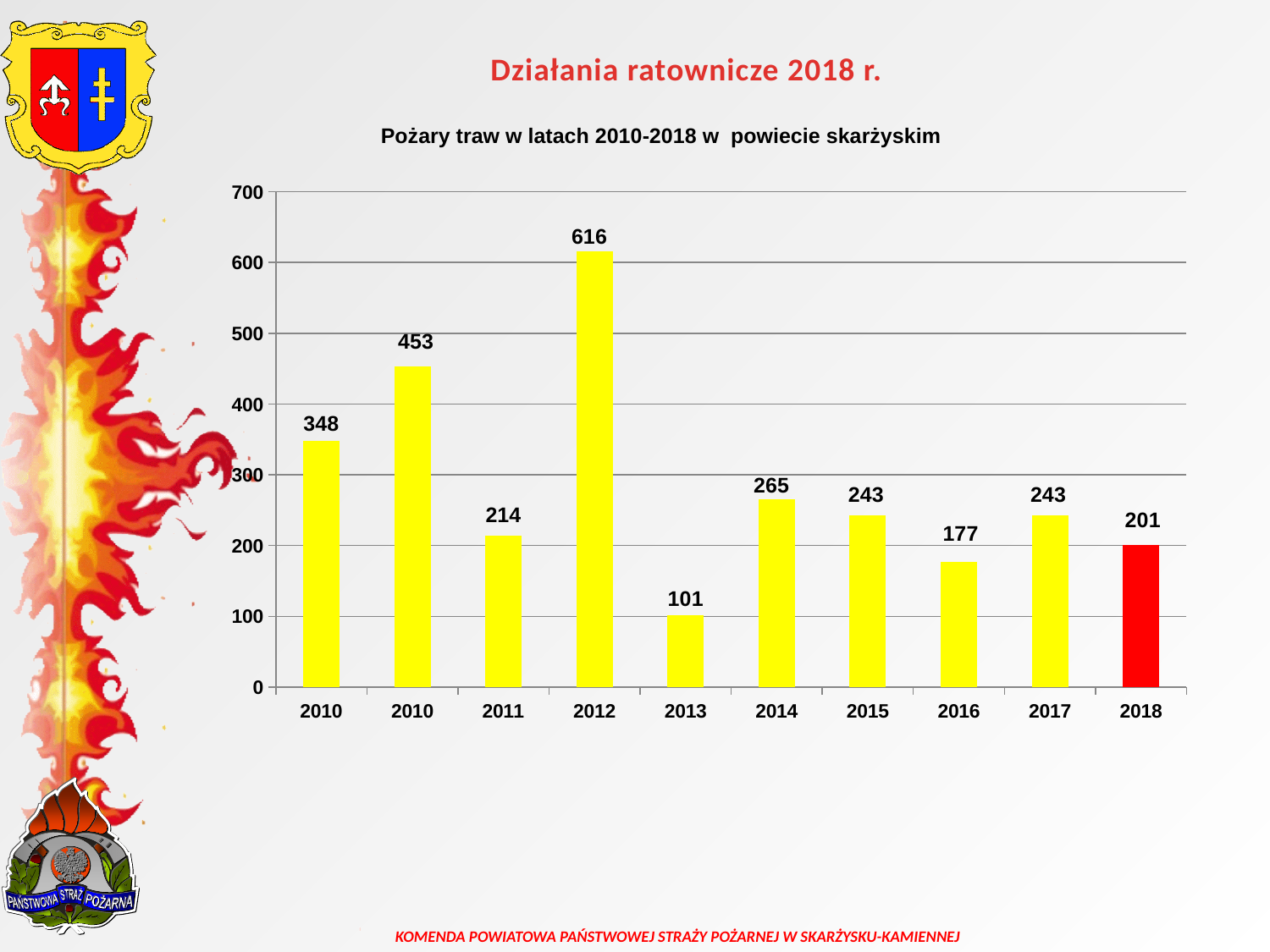
What kind of chart is shown on the slide? Bar chart What is the value shown for 2016? 177 What is the value shown for 2012? 616 Which year has the lowest number of grass fires in the chart? 2013 What is the difference between the values for 2017 and 2018? 42 What colour is the bar for 2018? Red What is the value shown for 2018? 201 Which year has the highest number of grass fires in the chart? 2012 How many bars are plotted in the chart? 10 Which year has a larger value, 2014 or 2015? 2014 What is the difference between the values for 2012 and 2013? 515 What is the value shown for 2013? 101